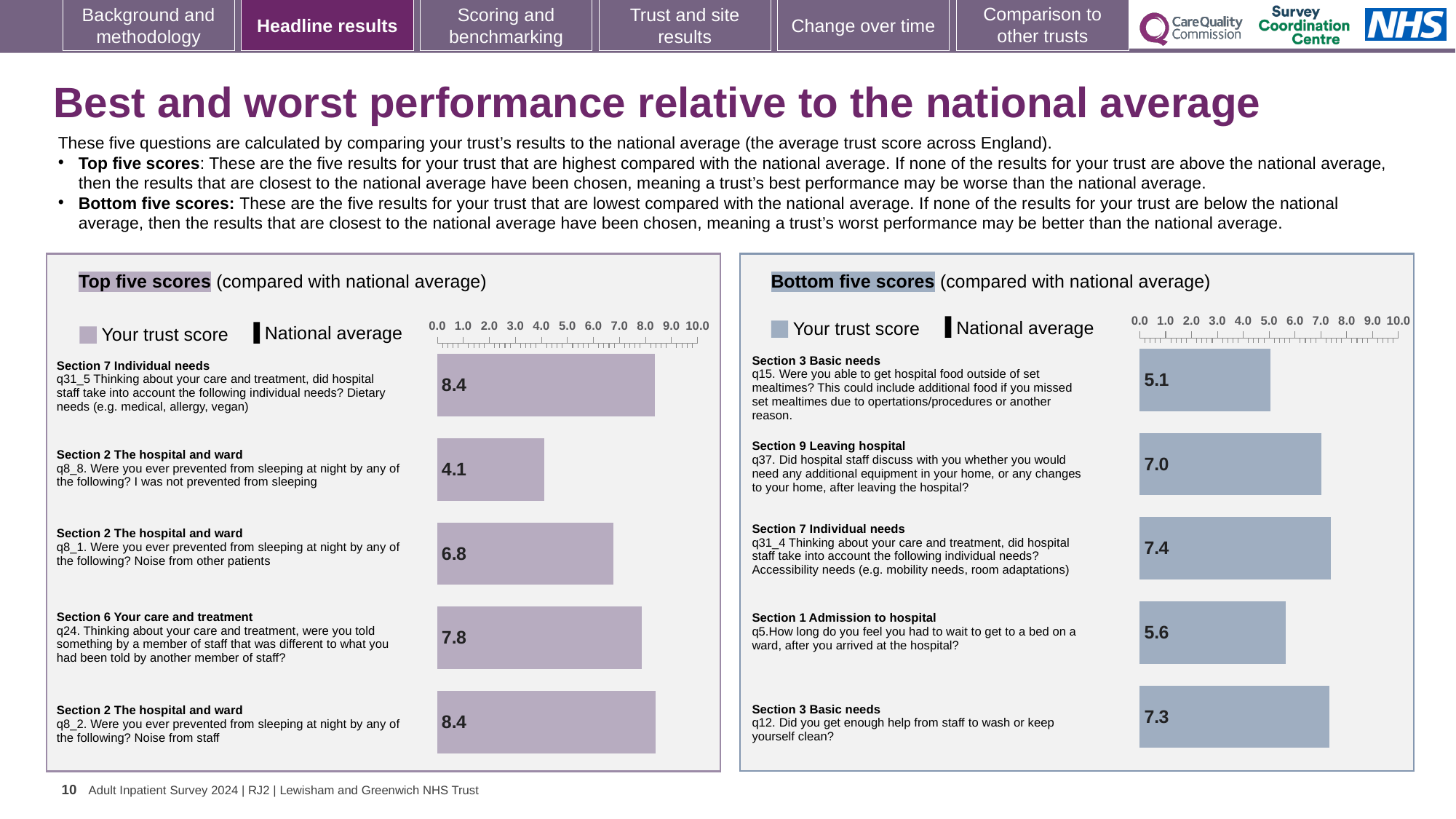
In the Bottom five scores chart, what is the trust score for q37 (discussing additional equipment or changes to your home after leaving hospital)? 7.0 What type of chart is used in the Bottom five scores panel? Bar chart In the Top five scores chart, is the trust score for q8_1 (Noise from other patients) greater or less than 5.0? greater How many bars are shown in the Top five scores chart? 5 In the Bottom five scores chart, what is the difference between the trust scores for q31_4 and q15? 2.3 What two entries does the legend of the Top five scores chart list? Your trust score and National average In the Bottom five scores chart, which question has the highest trust score? q31_4 (Accessibility needs) In the Top five scores chart, what is the difference between the trust scores for q24 and q8_8? 3.7 In the Top five scores chart, which question has the lowest trust score? q8_8 (I was not prevented from sleeping) In the Top five scores chart, what is the trust score for q8_8 (I was not prevented from sleeping)? 4.1 In the Bottom five scores chart, which has the larger trust score: q5 (wait to get to a bed) or q12 (help to wash or keep clean)? q12 In the Bottom five scores chart, which question has the lowest trust score? q15 (hospital food outside of set mealtimes)